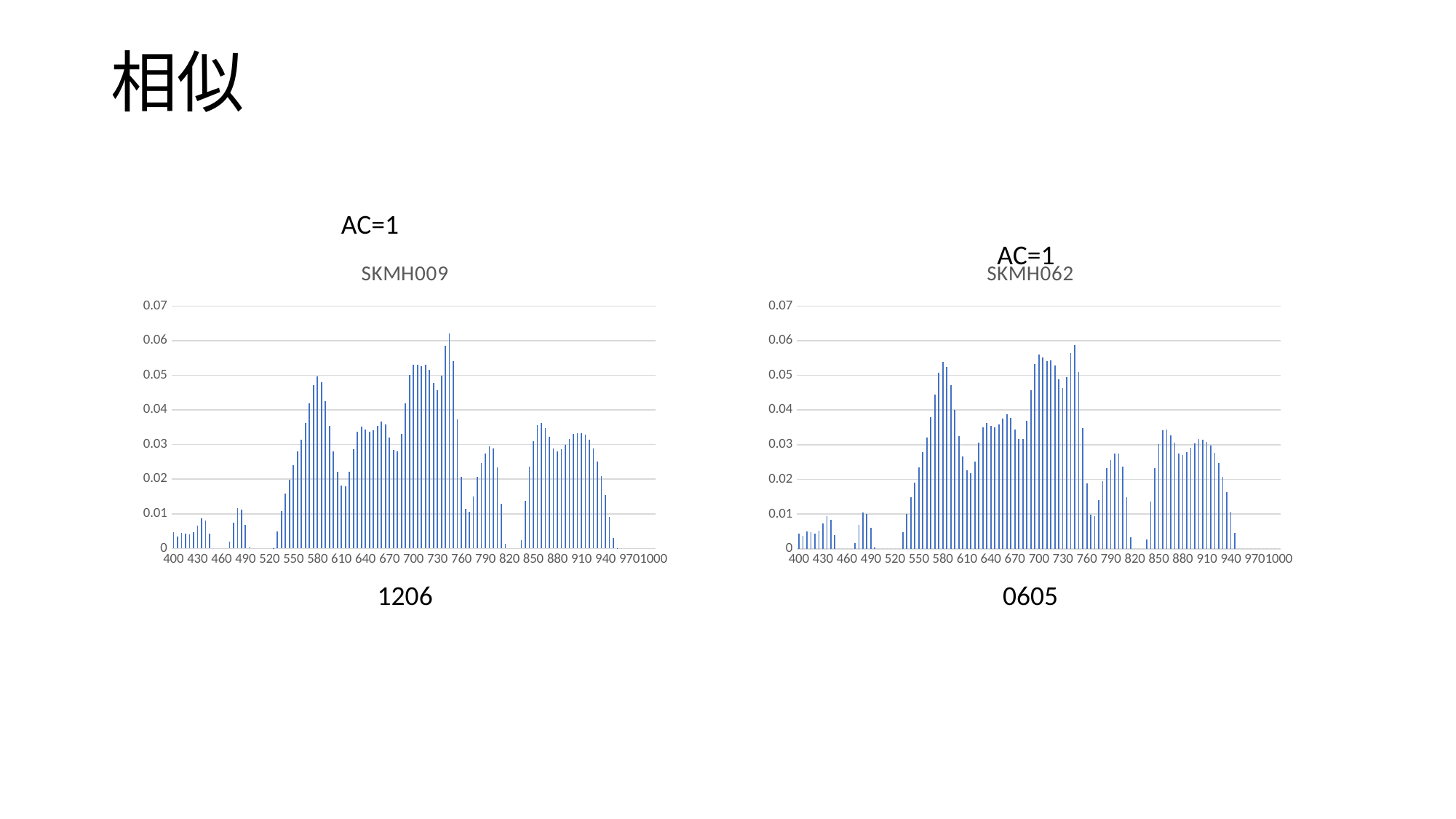
What is the title of the chart on the right? SKMH062 What is the title of the chart on the left? SKMH009 In the SKMH009 chart, is the value at 850 greater or less than 0.02? greater In the SKMH062 chart, is the value at 880 greater or less than 0.02? greater In the SKMH009 chart, is the value at 400 greater or less than 0.01? less What kind of chart is the SKMH009 chart on the left? bar chart In the SKMH009 chart, which is larger, the value at 580 or the value at 850? 580 In the SKMH062 chart, which is larger, the value at 580 or the value at 880? 580